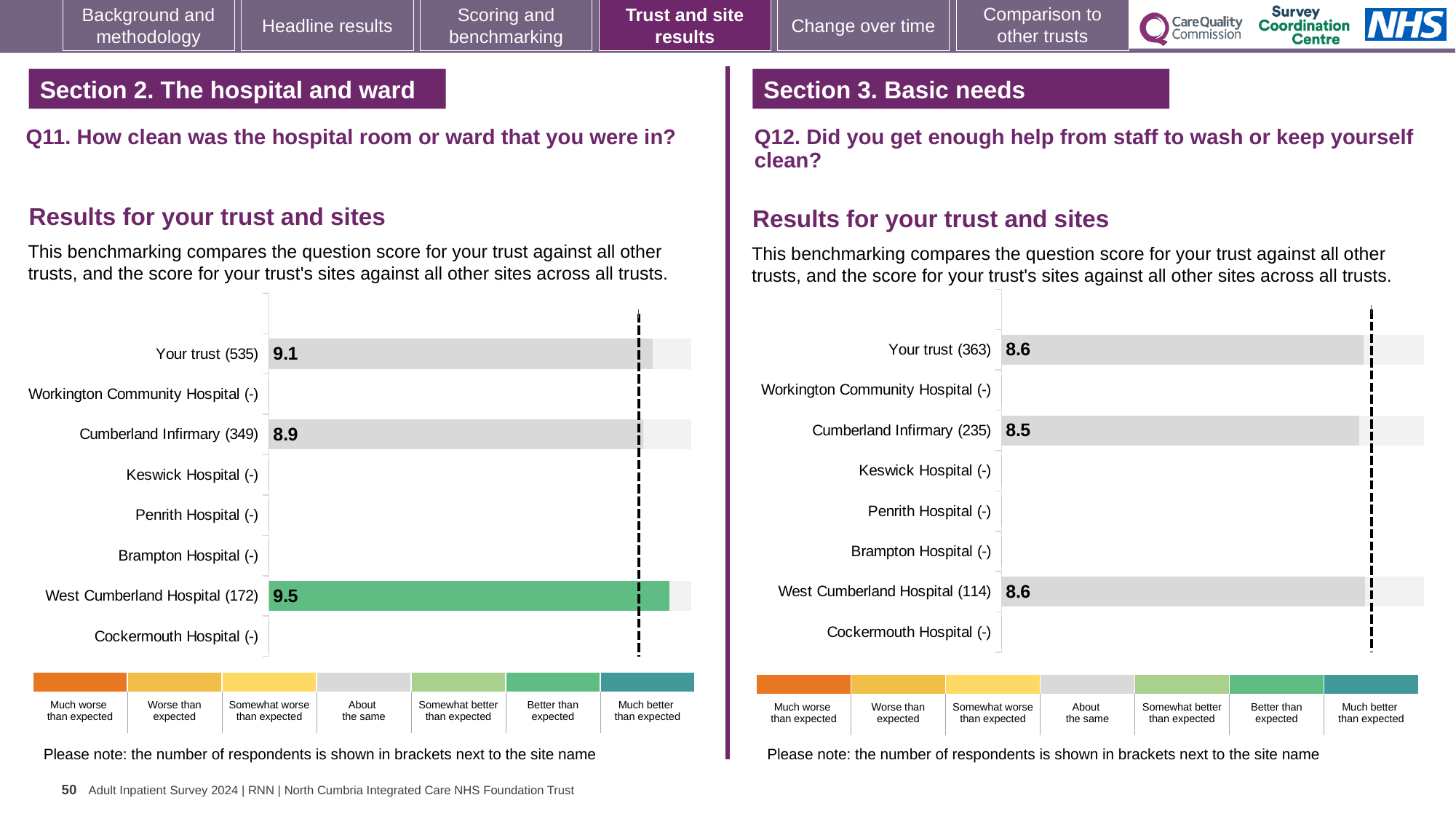
In the Q12 chart on the right, which has the lower score, Cumberland Infirmary or West Cumberland Hospital? Cumberland Infirmary In the Q11 chart on the left, what is the score for Your trust (535)? 9.1 How many site rows (including Your trust) are listed in the Q12 chart on the right? 8 In the Q11 chart on the left, which site with a plotted score has the highest value? West Cumberland Hospital (172) In the Q11 chart on the left, what is the score for West Cumberland Hospital (172)? 9.5 In the Q12 chart on the right, what is the score for Your trust (363)? 8.6 In the Q11 chart on the left, what is the score for Cumberland Infirmary (349)? 8.9 In the Q12 chart on the right, what is the score for West Cumberland Hospital (114)? 8.6 In the Q11 chart on the left, which bar is shown in green rather than grey? West Cumberland Hospital (172) In the Q11 chart on the left, what is the difference between the scores for West Cumberland Hospital and Cumberland Infirmary? 0.6 In the Q12 chart on the right, what is the score for Cumberland Infirmary (235)? 8.5 What kind of chart is used for the Q11 results on the left? Bar chart